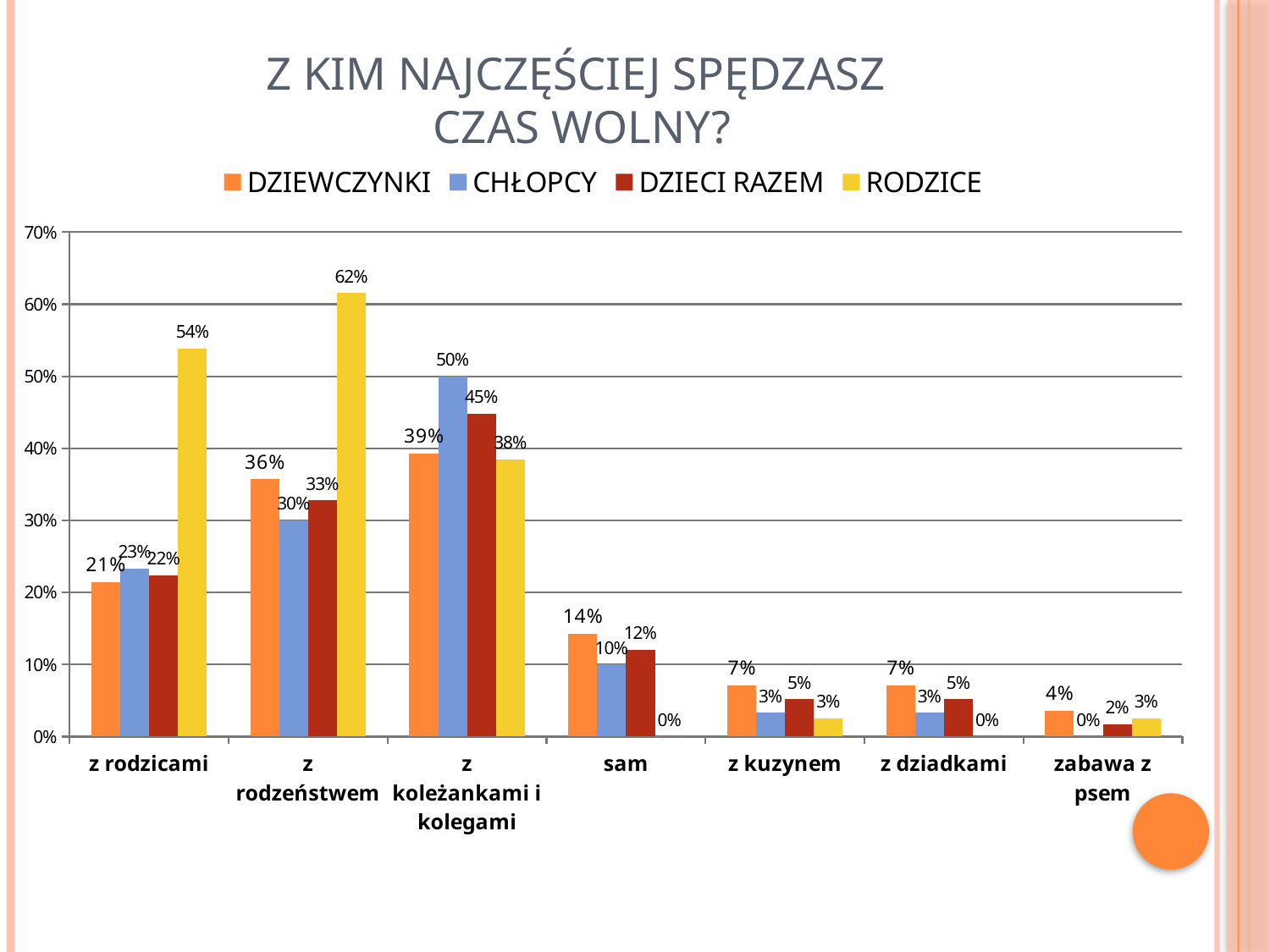
Which category has the lowest value for the DZIEWCZYNKI series? zabawa z psem How many categories are shown on the x axis? 7 In the 'z koleżankami i kolegami' category, which is larger: the CHŁOPCY value or the RODZICE value? CHŁOPCY What is the difference between the RODZICE value and the DZIEWCZYNKI value in the 'z rodzicami' category? 33% What is the value for DZIEWCZYNKI in the 'sam' category? 14% What is the value for RODZICE in the 'z rodzeństwem' category? 62% What is the value for CHŁOPCY in the 'z koleżankami i kolegami' category? 50% How many series does the legend list? 4 What kind of chart is shown on the slide? bar chart What is the value for DZIECI RAZEM in the 'z rodzicami' category? 22% Which category has the highest value for the RODZICE series? z rodzeństwem What is the title of the chart? Z KIM NAJCZĘŚCIEJ SPĘDZASZ CZAS WOLNY?